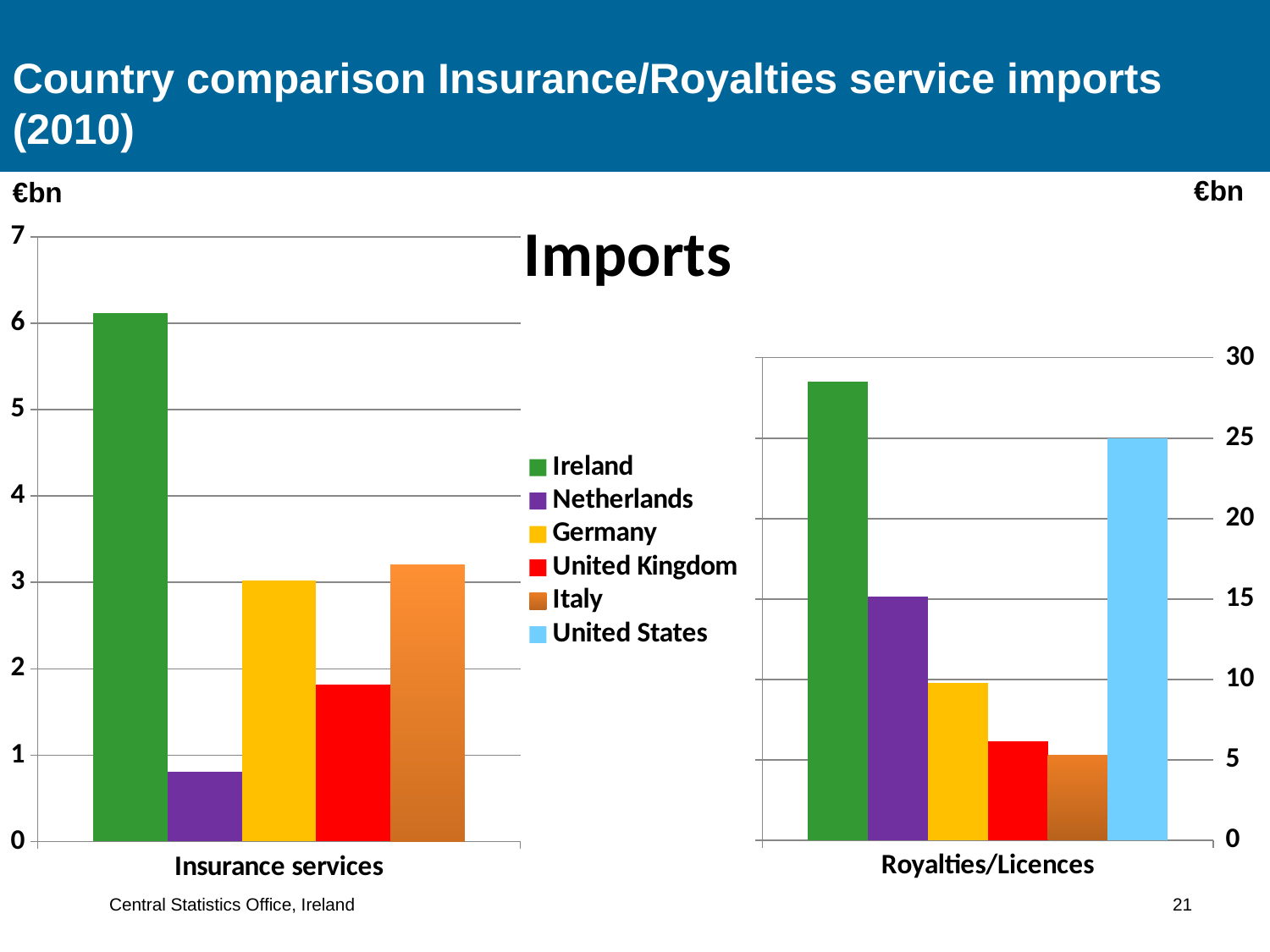
What kind of chart is shown on the slide? bar chart For Royalties/Licences, which is larger: Ireland or the United States? Ireland Is the value for Ireland in Royalties/Licences greater or less than 25? greater Which country has the highest value for Insurance services? Ireland Which country has the lowest value for Insurance services? Netherlands How many bars are shown for the Royalties/Licences group? 6 Is the value for the United Kingdom in Royalties/Licences greater or less than 10? less Which country has the lowest value for Royalties/Licences? Italy How many series does the legend list? 6 Is the value for Ireland in Insurance services greater or less than 5? greater Which country has the highest value for Royalties/Licences? Ireland